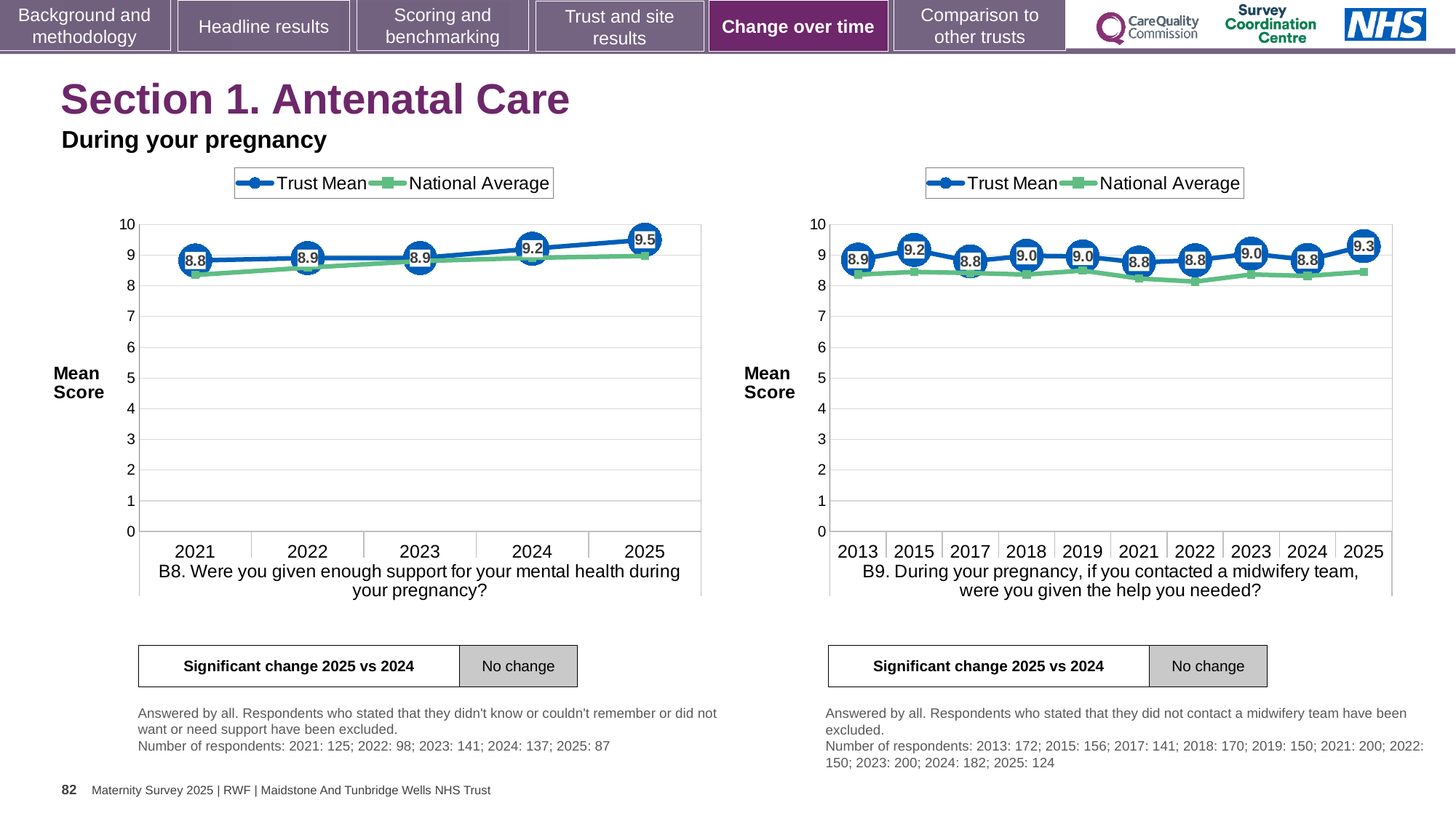
On the left chart (B8), which year has the highest Trust Mean? 2025 On the right chart (B9), what is the Trust Mean for 2015? 9.2 On the left chart (B8), what is the Trust Mean for 2021? 8.8 On the left chart (B8), does the Trust Mean rise or fall from 2021 to 2025? rise On the right chart (B9), how many years are shown on the x axis? 10 How many series does the legend of the left chart (B8) list? 2 On the left chart (B8), what is the difference between the Trust Mean in 2025 and in 2024? 0.3 On the right chart (B9), is the National Average for 2022 greater or less than 9? less On the right chart (B9), which year has the highest Trust Mean? 2025 On the left chart (B8), what is the Trust Mean for 2025? 9.5 On the left chart (B8), how many years are shown on the x axis? 5 On the right chart (B9), what is the Trust Mean for 2025? 9.3